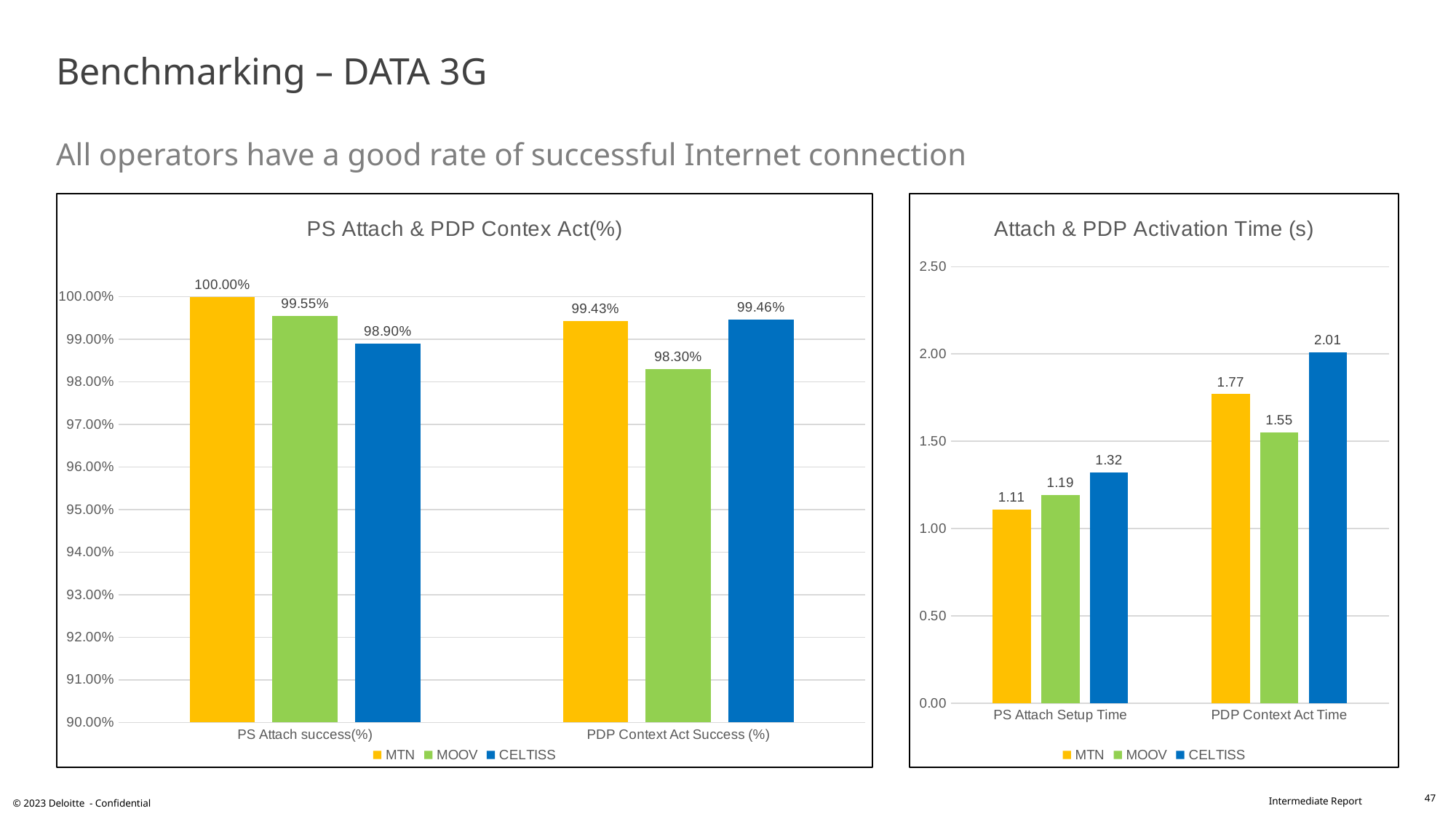
In the 'PS Attach & PDP Contex Act(%)' chart, what is the value for MTN in PS Attach success(%)? 100.00% In the 'PS Attach & PDP Contex Act(%)' chart, what is the difference between MTN and CELTISS in PS Attach success(%)? 1.10% In the 'Attach & PDP Activation Time (s)' chart, which operator has the highest PDP Context Act Time? CELTISS In the 'PS Attach & PDP Contex Act(%)' chart, how many series does the legend list? 3 What kind of chart is the 'Attach & PDP Activation Time (s)' chart? Bar chart In the 'PS Attach & PDP Contex Act(%)' chart, how many categories are shown on the x axis? 2 In the 'PS Attach & PDP Contex Act(%)' chart, which operator has the lowest PS Attach success(%)? CELTISS In the 'Attach & PDP Activation Time (s)' chart, what is the value for CELTISS in PDP Context Act Time? 2.01 In the 'Attach & PDP Activation Time (s)' chart, what is the difference between MTN and MOOV in PDP Context Act Time? 0.22 In the 'PS Attach & PDP Contex Act(%)' chart, what is the value for MOOV in PDP Context Act Success (%)? 98.30% In the 'Attach & PDP Activation Time (s)' chart, what is the value for MTN in PS Attach Setup Time? 1.11 In the 'Attach & PDP Activation Time (s)' chart, which is larger: MOOV's PS Attach Setup Time or CELTISS's PS Attach Setup Time? CELTISS's PS Attach Setup Time